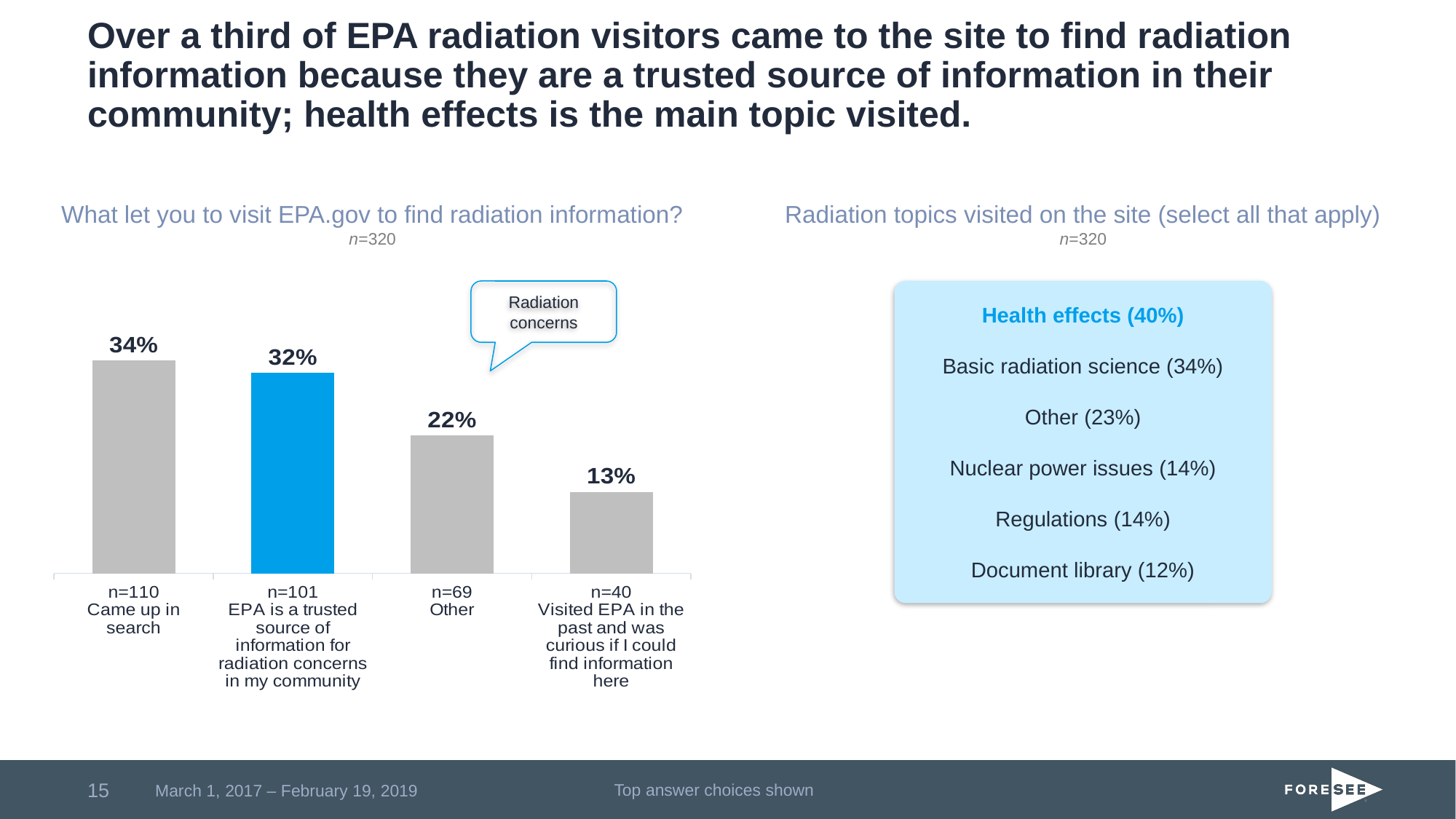
In the chart 'What let you to visit EPA.gov to find radiation information?', which answer choice has the highest percentage? Came up in search In the chart 'What let you to visit EPA.gov to find radiation information?', what is the n value shown under the 'Other' bar? n=69 How many answer choices (bars) are shown in the chart 'What let you to visit EPA.gov to find radiation information?' 4 In the chart 'What let you to visit EPA.gov to find radiation information?', what percentage is shown for 'Other'? 22% In the chart 'What let you to visit EPA.gov to find radiation information?', what percentage chose 'EPA is a trusted source of information for radiation concerns in my community'? 32% In the chart 'What let you to visit EPA.gov to find radiation information?', which answer choice has the lowest percentage? Visited EPA in the past and was curious if I could find information here In the chart 'What let you to visit EPA.gov to find radiation information?', which is larger: the percentage for 'Other' or for 'Visited EPA in the past and was curious if I could find information here'? Other What type of chart is 'What let you to visit EPA.gov to find radiation information?' Bar chart In the chart 'What let you to visit EPA.gov to find radiation information?', what is the difference in percentage points between 'Came up in search' and 'Other'? 12 percentage points In the chart 'What let you to visit EPA.gov to find radiation information?', what percentage of visitors had visited EPA in the past and were curious if they could find information there? 13% In the chart 'What let you to visit EPA.gov to find radiation information?', which bar is highlighted in blue? EPA is a trusted source of information for radiation concerns in my community In the chart 'What let you to visit EPA.gov to find radiation information?', what percentage of visitors said the site came up in search? 34%